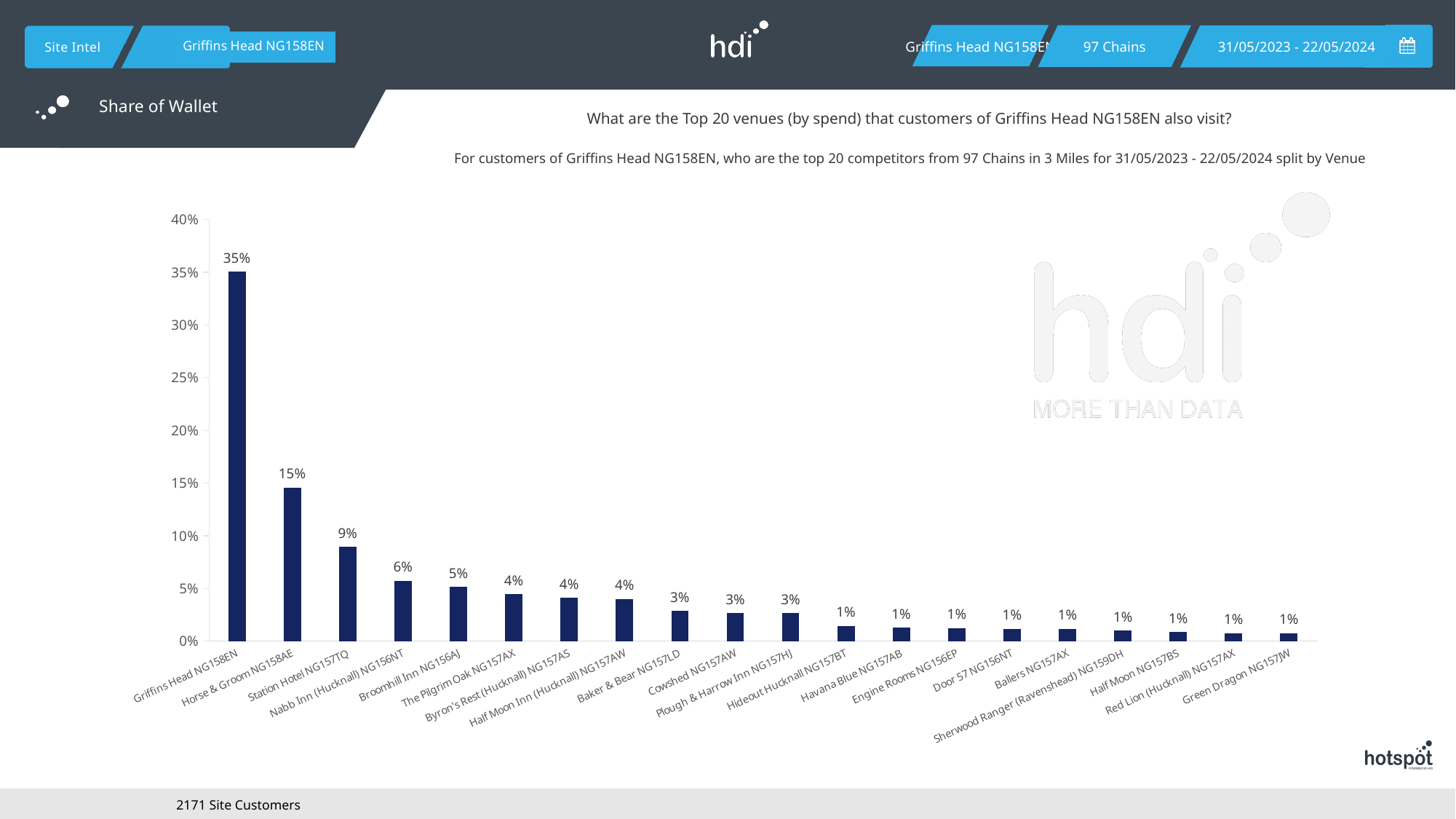
Do the values rise or fall moving from left to right along the x axis? fall What is the value for Horse & Groom NG158AE? 15% How many venues are plotted on the chart? 20 Which is larger, the value for Station Hotel NG157TQ or the value for Broomhill Inn NG156AJ? Station Hotel NG157TQ What is the value for Baker & Bear NG157LD? 3% What is the value for Nabb Inn (Hucknall) NG156NT? 6% What kind of chart is shown on the slide? bar chart What is the value for Station Hotel NG157TQ? 9% What is the difference between the values for Griffins Head NG158EN and Horse & Groom NG158AE? 20% Is the value for Griffins Head NG158EN greater or less than 30%? greater What is the value for Griffins Head NG158EN? 35% Which venue has the highest value on the chart? Griffins Head NG158EN